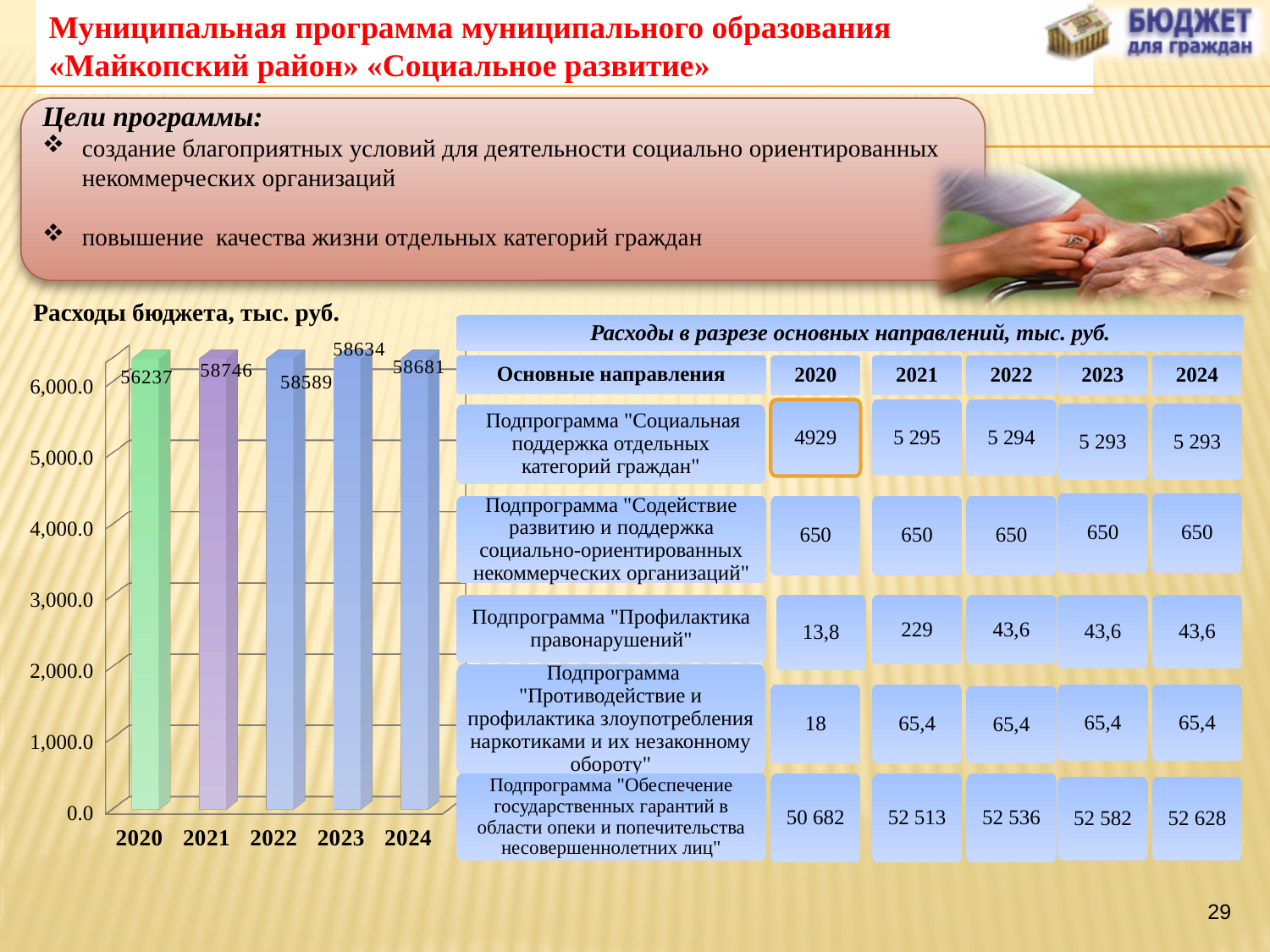
Which year has the highest value in the bar chart 'Расходы бюджета, тыс. руб.'? 2021 In the bar chart 'Расходы бюджета, тыс. руб.', what is the difference between the values for 2021 and 2020? 2509 What is the value for 2023 in the bar chart 'Расходы бюджета, тыс. руб.'? 58634 What is the value for 2024 in the bar chart 'Расходы бюджета, тыс. руб.'? 58681 What kind of chart is 'Расходы бюджета, тыс. руб.'? bar chart How many years are shown in the bar chart 'Расходы бюджета, тыс. руб.'? 5 Which year has the lowest value in the bar chart 'Расходы бюджета, тыс. руб.'? 2020 In the bar chart 'Расходы бюджета, тыс. руб.', which is larger, the value for 2022 or the value for 2023? 2023 What is the value for 2020 in the bar chart 'Расходы бюджета, тыс. руб.'? 56237 In the bar chart 'Расходы бюджета, тыс. руб.', does the value rise or fall from 2020 to 2021? rise In the bar chart 'Расходы бюджета, тыс. руб.', what is the difference between the values for 2024 and 2023? 47 What is the value for 2021 in the bar chart 'Расходы бюджета, тыс. руб.'? 58746